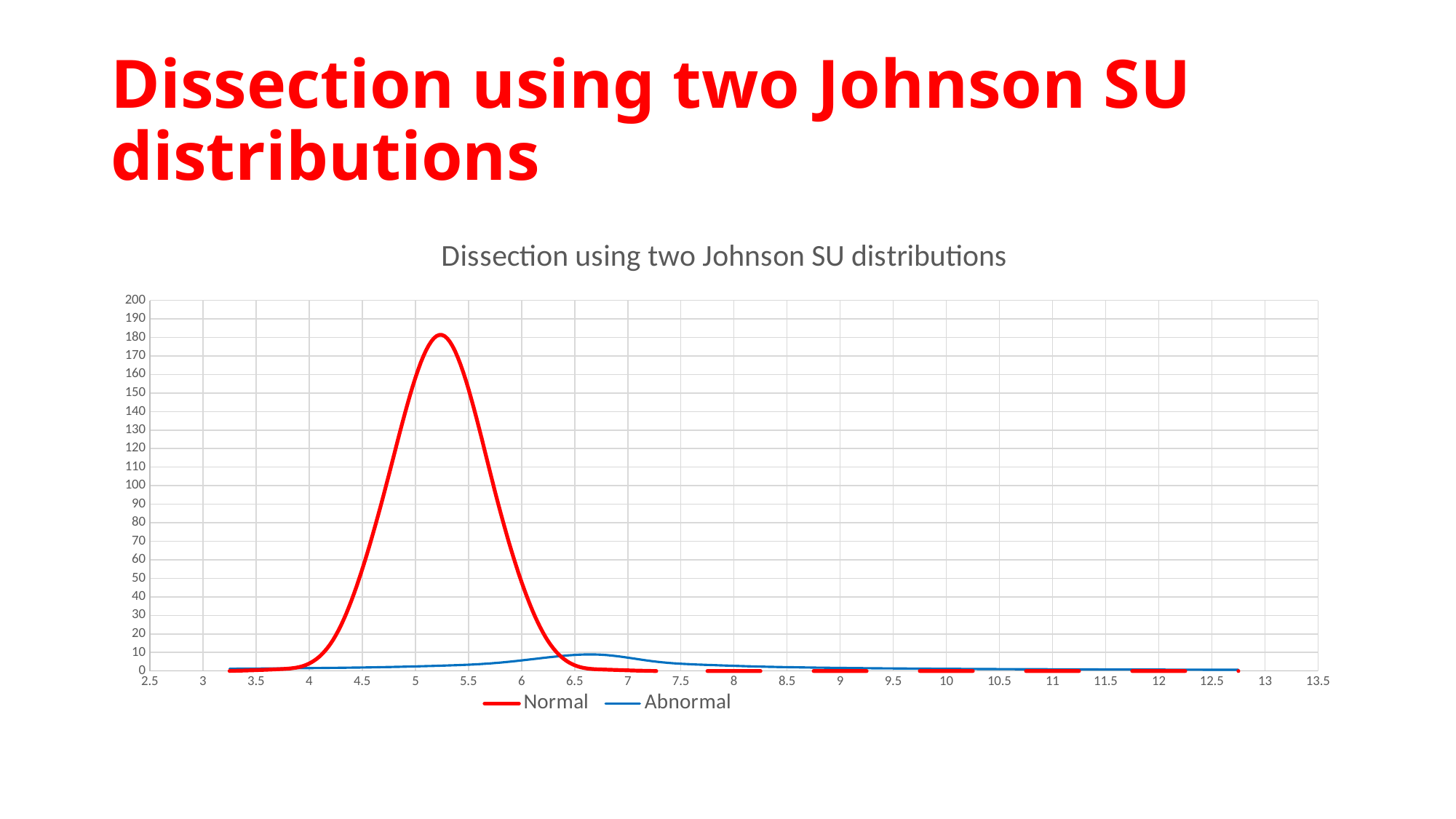
Which series reaches the highest value on the chart? Normal Which colour is used for the Abnormal series? blue Is the value of the Normal series at x = 5 greater or less than 100? greater What is the title of the chart? Dissection using two Johnson SU distributions Is the peak value of the Abnormal series greater or less than 20? less How many series does the legend list? 2 Between x = 4 and x = 5, does the Normal series rise or fall? rise Is the peak value of the Normal series greater or less than 170? greater Between x = 5.5 and x = 6.5, does the Normal series rise or fall? fall What kind of chart is shown on the slide? line chart